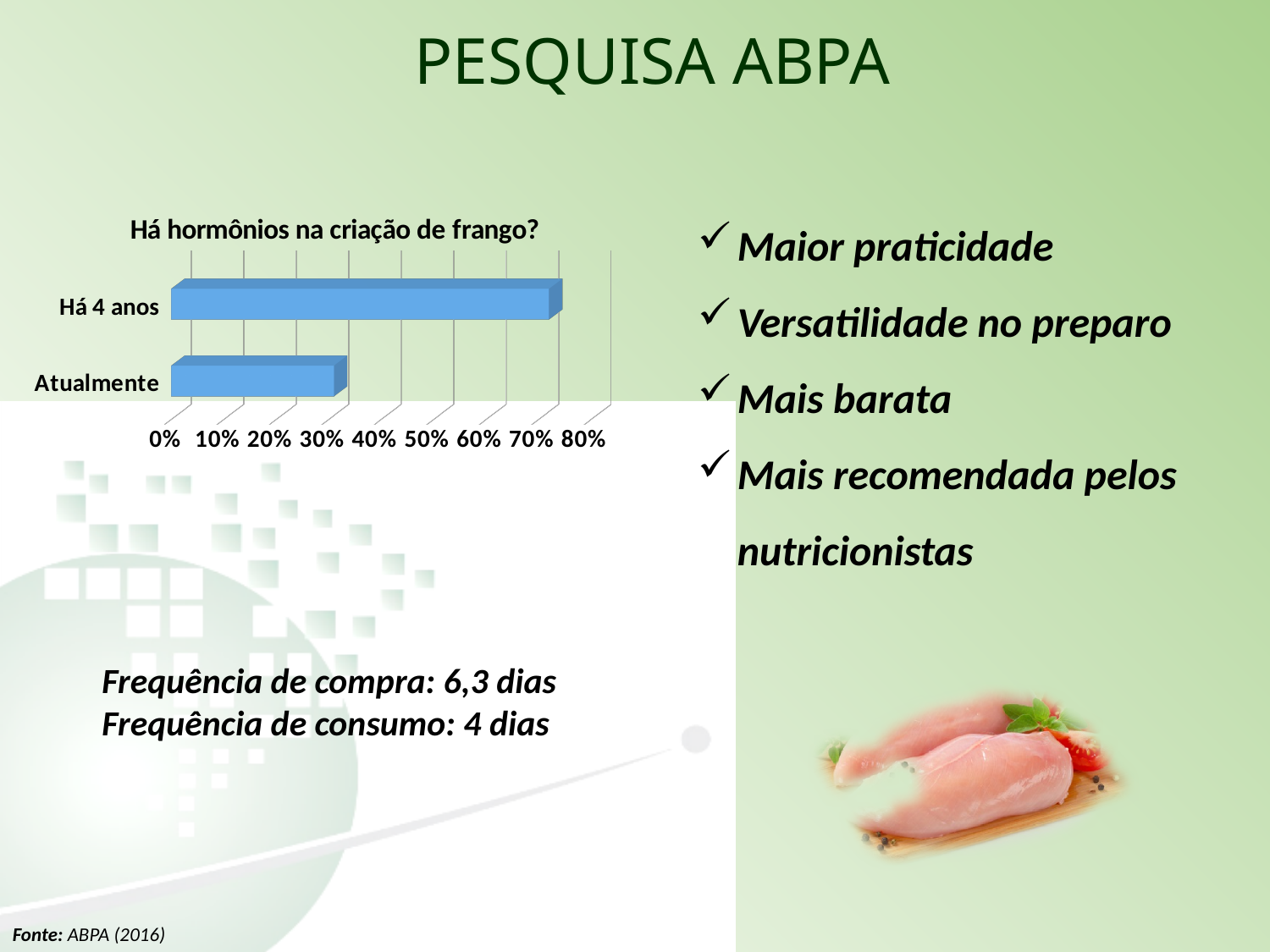
What is the title of the chart? Há hormônios na criação de frango? What kind of chart is shown on the slide? bar chart Which category has the highest value in the chart? Há 4 anos Is the value for Há 4 anos greater or less than 80%? less What is the highest value shown on the chart's percentage axis? 80% How many categories does the chart show? 2 Is the value for Há 4 anos greater or less than 60%? greater Which is larger, the value for Há 4 anos or the value for Atualmente? Há 4 anos Is the value for Atualmente greater or less than 20%? greater Which category has the lowest value in the chart? Atualmente